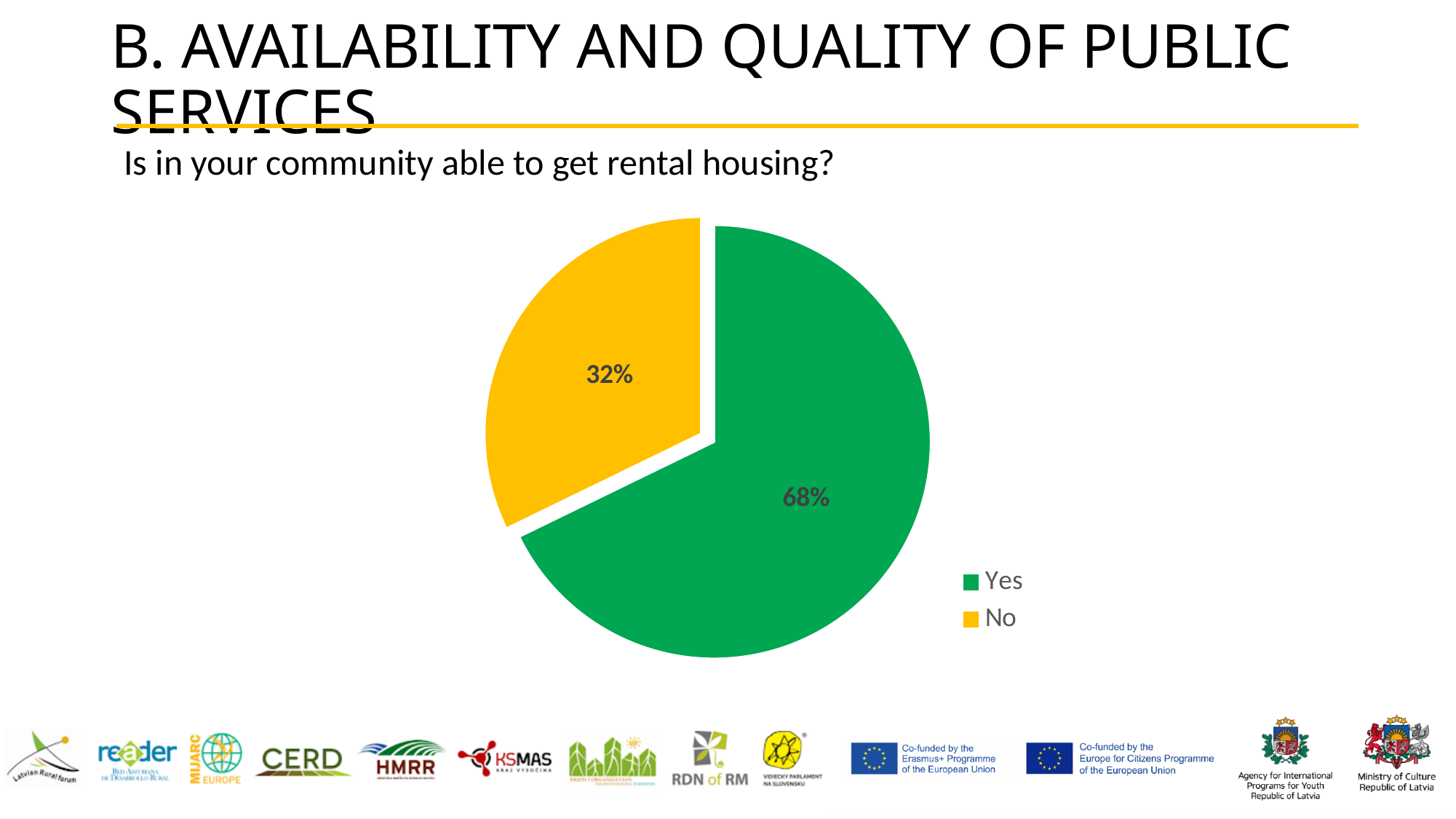
How many entries does the legend list? 2 Which response has the smallest share of the pie? No What kind of chart is shown on the slide? Pie chart What is the difference in percentage points between the Yes and No shares? 36 What question does the chart answer, according to the text above it? Is in your community able to get rental housing? What share of the pie does the No slice represent? 32% How many slices does the pie chart have? 2 Which response has the largest share of the pie? Yes What percentage of respondents answered No? 32% What percentage of respondents answered Yes? 68% What colour is the Yes slice? Green Which is larger, the share for Yes or the share for No? Yes